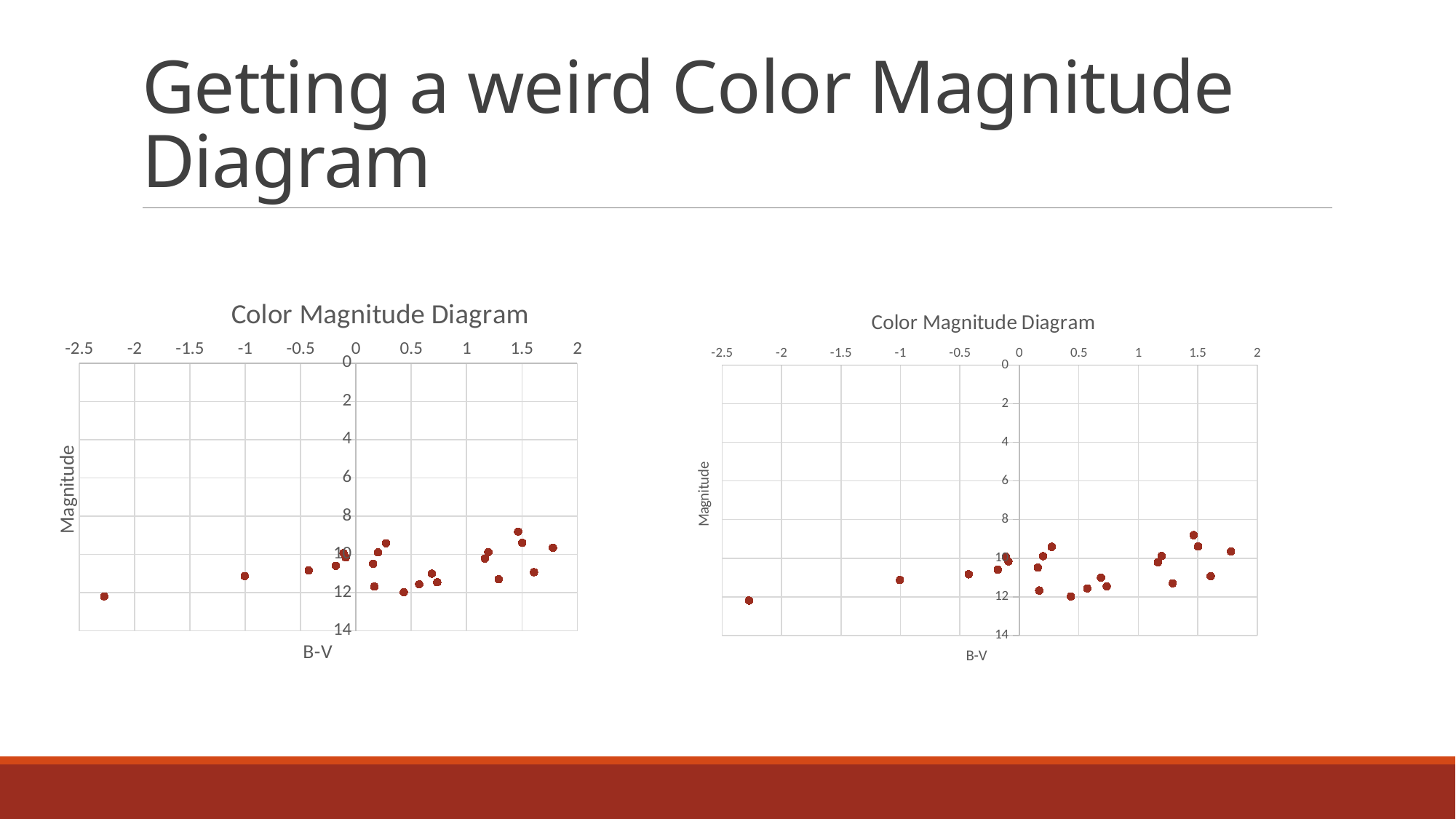
What kind of chart is the chart on the left of the slide? scatter chart On the left chart, is the magnitude of the point at B-V of about 0.4 greater or less than 10? greater How many charts are shown on the slide? 2 On the left chart, is the magnitude of the point with the lowest B-V value (near -2.5) greater or less than 10? greater On the right chart, is the magnitude of the point at B-V of about -1 greater or less than 10? greater On the right chart, what is the largest value shown on the vertical (Magnitude) axis? 14 On the left chart, what is the smallest value shown on the horizontal (B-V) axis? -2.5 What is the title of the chart on the right of the slide? Color Magnitude Diagram On the left chart, what is the label of the horizontal axis? B-V